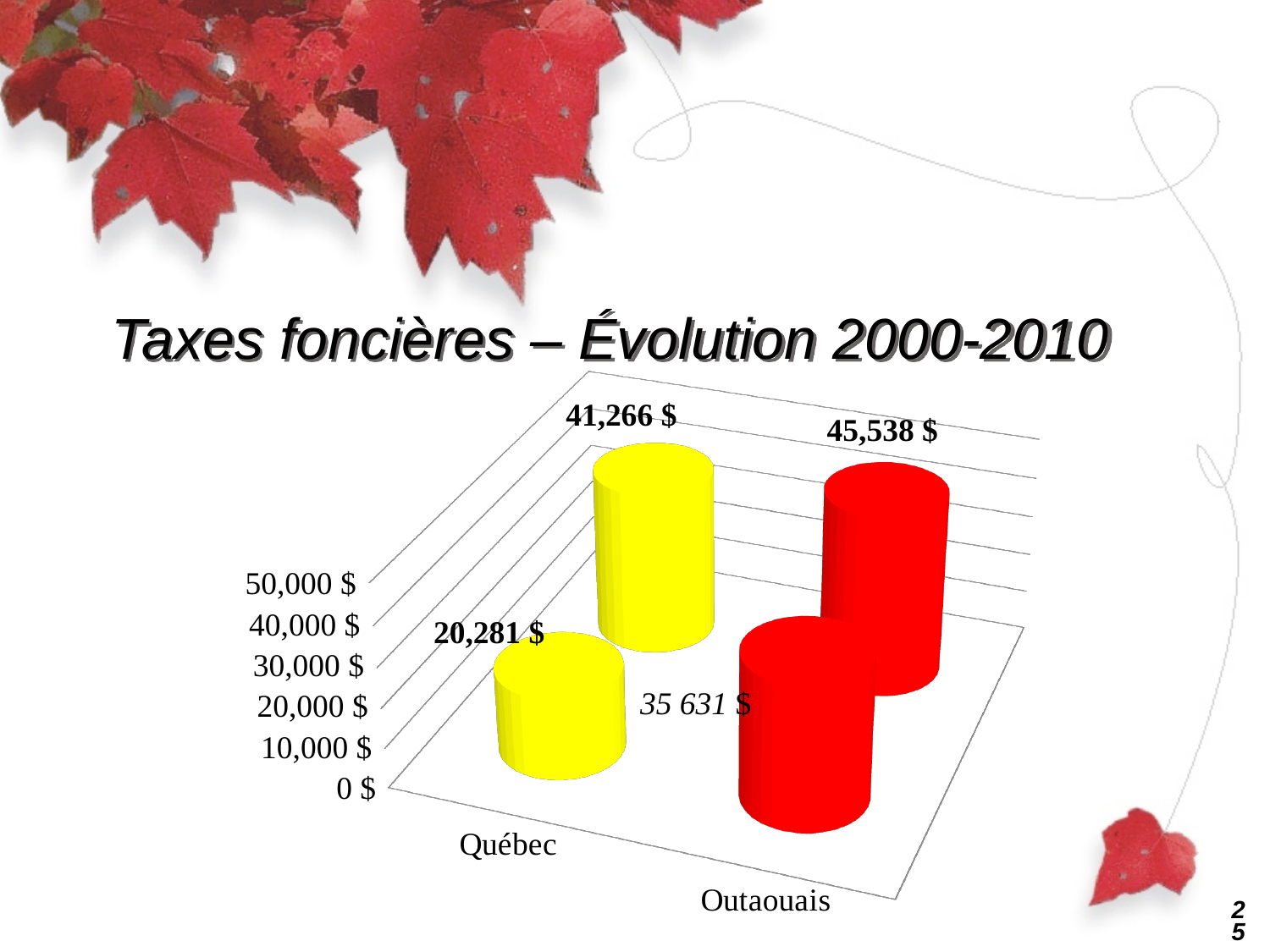
How many categories are shown on the x axis of the chart? 2 What is the value labelled on the back (taller) bar for Québec? 41,266 $ What is the value labelled on the back (taller) bar for Outaouais? 45,538 $ Which front bar is larger, Québec or Outaouais? Outaouais What is the title of the chart on the slide? Taxes foncières – Évolution 2000-2010 Which bar has the lowest labelled value on the chart? Québec front bar, 20,281 $ Is the value of the front bar for Québec greater or less than 30,000 $? less Which bar has the highest labelled value on the chart? Outaouais back bar, 45,538 $ What is the difference between the back bar and the front bar for Québec? 20,985 $ What is the value labelled on the front (shorter) bar for Québec? 20,281 $ What kind of chart is shown on the slide? Bar chart What is the value labelled on the front (shorter) bar for Outaouais? 35 631 $